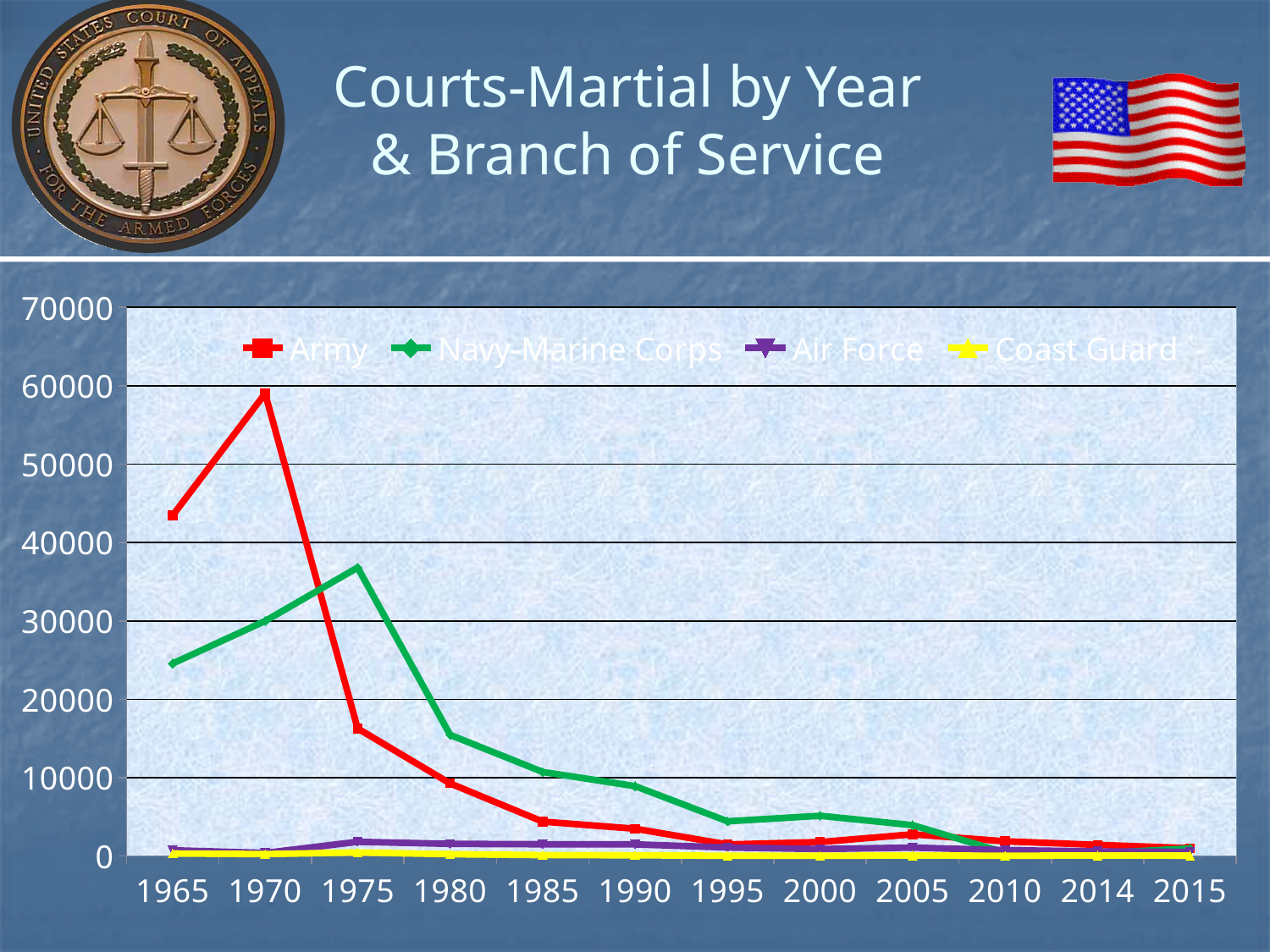
Is the Navy-Marine Corps value for 1980 greater or less than 20000? less In which year does the Army series reach its highest value? 1970 In 1965, which series has the larger value, Army or Navy-Marine Corps? Army How many series does the legend list? 4 Is the Army value for 1975 greater or less than 20000? less What kind of chart is shown on the slide? line chart Does the Army series rise or fall from 1970 to 2015? fall How many years are plotted along the x axis? 12 Is the Army value for 1965 greater or less than 40000? greater In 1975, which series has the larger value, Army or Navy-Marine Corps? Navy-Marine Corps In which year does the Navy-Marine Corps series reach its highest value? 1975